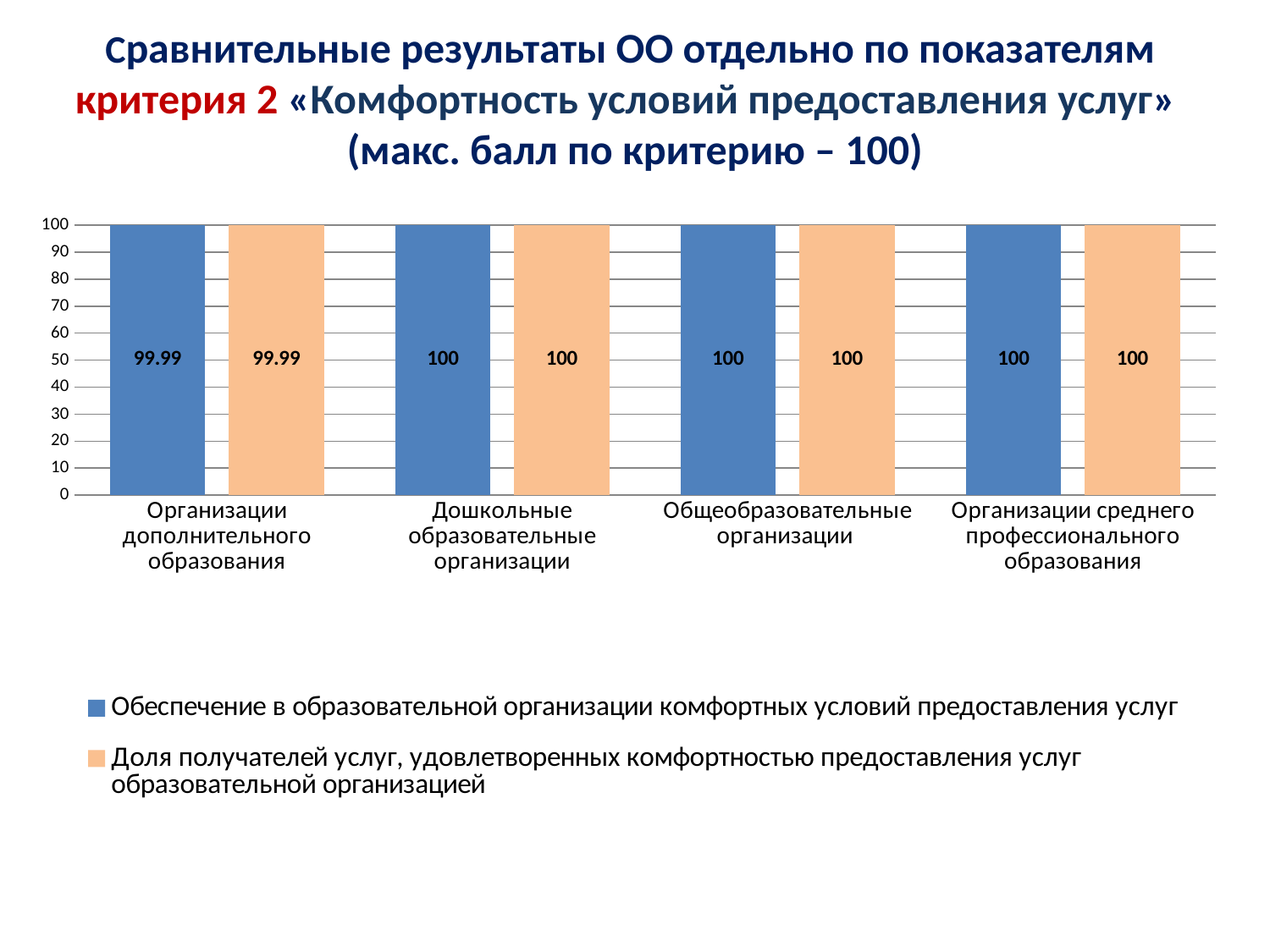
What is the value of «Доля получателей услуг, удовлетворенных комфортностью предоставления услуг образовательной организацией» for Организации среднего профессионального образования? 100 What is the value of «Обеспечение в образовательной организации комфортных условий предоставления услуг» for Общеобразовательные организации? 100 What is the maximum score for the criterion stated in the slide title? 100 How many categories are shown on the x axis of the chart? 4 What is the difference between the «Доля получателей услуг, удовлетворенных комфортностью предоставления услуг образовательной организацией» values for Дошкольные образовательные организации and Организации дополнительного образования? 0.01 Which category has the lowest value for «Обеспечение в образовательной организации комфортных условий предоставления услуг»? Организации дополнительного образования What is the value of «Обеспечение в образовательной организации комфортных условий предоставления услуг» for Организации дополнительного образования? 99.99 What kind of chart is shown on the slide? bar chart How many series does the legend list? 2 Is the value for Организации дополнительного образования in the «Обеспечение в образовательной организации комфортных условий предоставления услуг» series greater or less than 90? greater What is the value of «Доля получателей услуг, удовлетворенных комфортностью предоставления услуг образовательной организацией» for Дошкольные образовательные организации? 100 Which is larger: the «Обеспечение в образовательной организации комфортных условий предоставления услуг» value for Общеобразовательные организации or for Организации дополнительного образования? Общеобразовательные организации